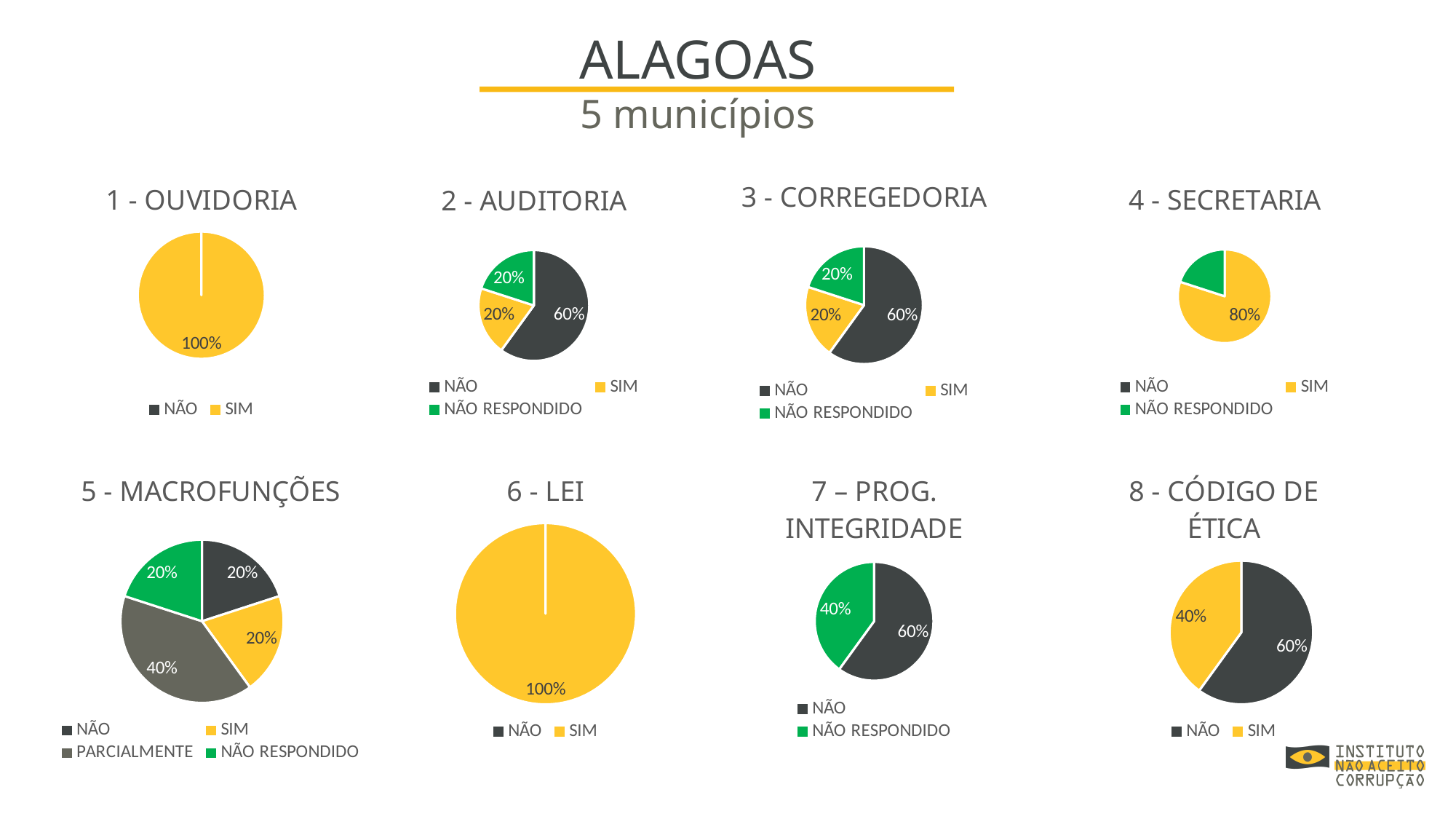
In the "5 - MACROFUNÇÕES" chart, what percentage is shown for PARCIALMENTE? 40% In the "1 - OUVIDORIA" chart, what percentage is shown for SIM? 100% In the "5 - MACROFUNÇÕES" chart, which category has the largest slice? PARCIALMENTE What kind of chart is used for "6 - LEI"? Pie chart In the "2 - AUDITORIA" chart, what percentage is shown for NÃO? 60% In the "7 – PROG. INTEGRIDADE" chart, what is the difference between the NÃO and NÃO RESPONDIDO percentages? 20% In the "2 - AUDITORIA" chart, what colour is the NÃO RESPONDIDO slice? Green How many pie charts are shown on the slide? 8 How many categories does the legend of the "5 - MACROFUNÇÕES" chart list? 4 In the "4 - SECRETARIA" chart, what percentage is shown for SIM? 80% In the "8 - CÓDIGO DE ÉTICA" chart, which is larger, NÃO or SIM? NÃO In the "3 - CORREGEDORIA" chart, what percentage is shown for NÃO RESPONDIDO? 20%